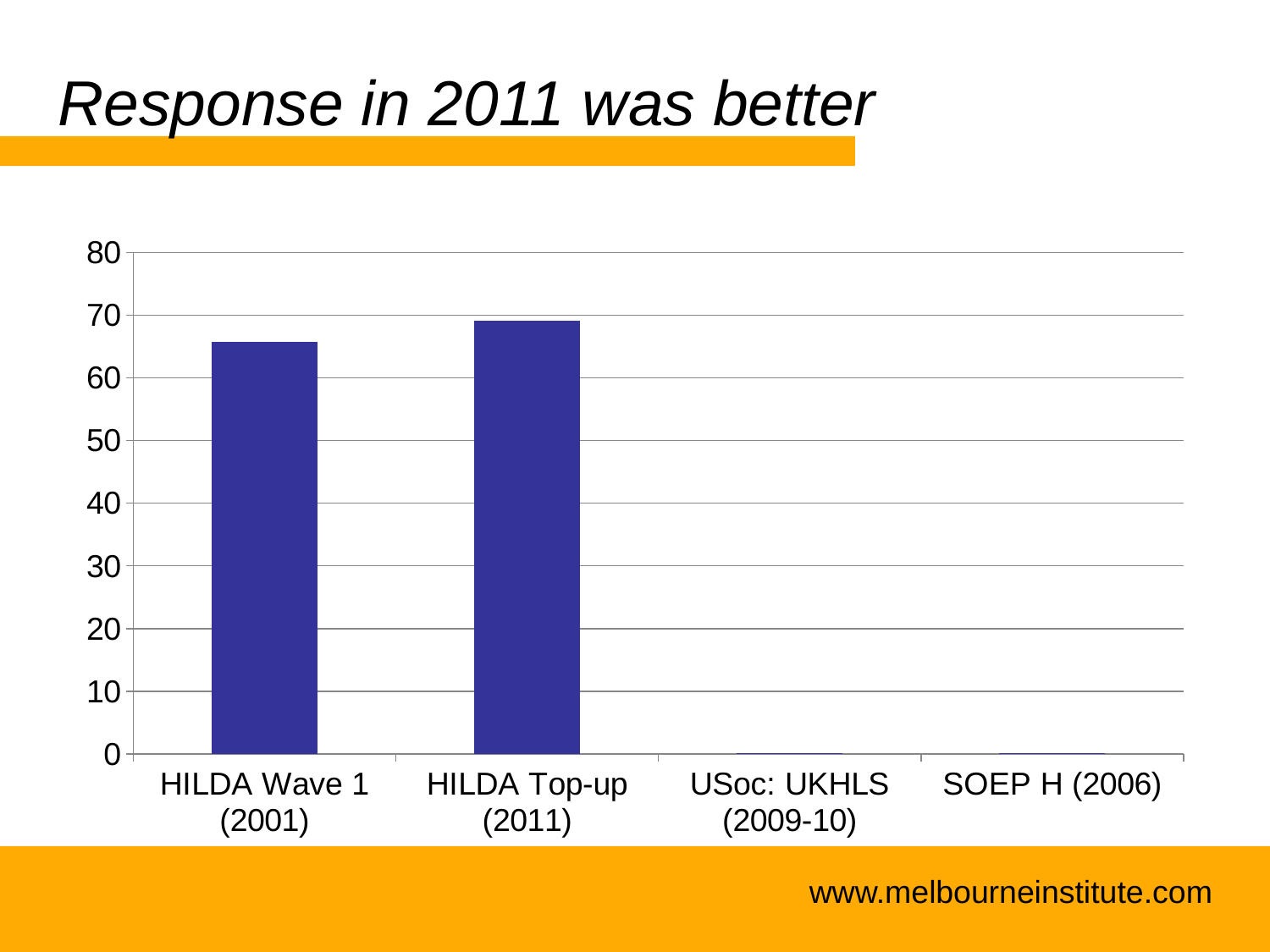
Is the value for HILDA Wave 1 (2001) greater or less than 60? greater Is the value for USoc: UKHLS (2009-10) greater or less than 10? less What is the title of the slide containing the chart? Response in 2011 was better Is the value for SOEP H (2006) greater or less than 10? less Which category has the highest bar in the chart? HILDA Top-up (2011) Which is larger, the value for HILDA Wave 1 (2001) or the value for HILDA Top-up (2011)? HILDA Top-up (2011) What is the highest value shown on the y axis of the chart? 80 How many categories are shown on the x axis of the chart? 4 What kind of chart is shown on the slide? bar chart